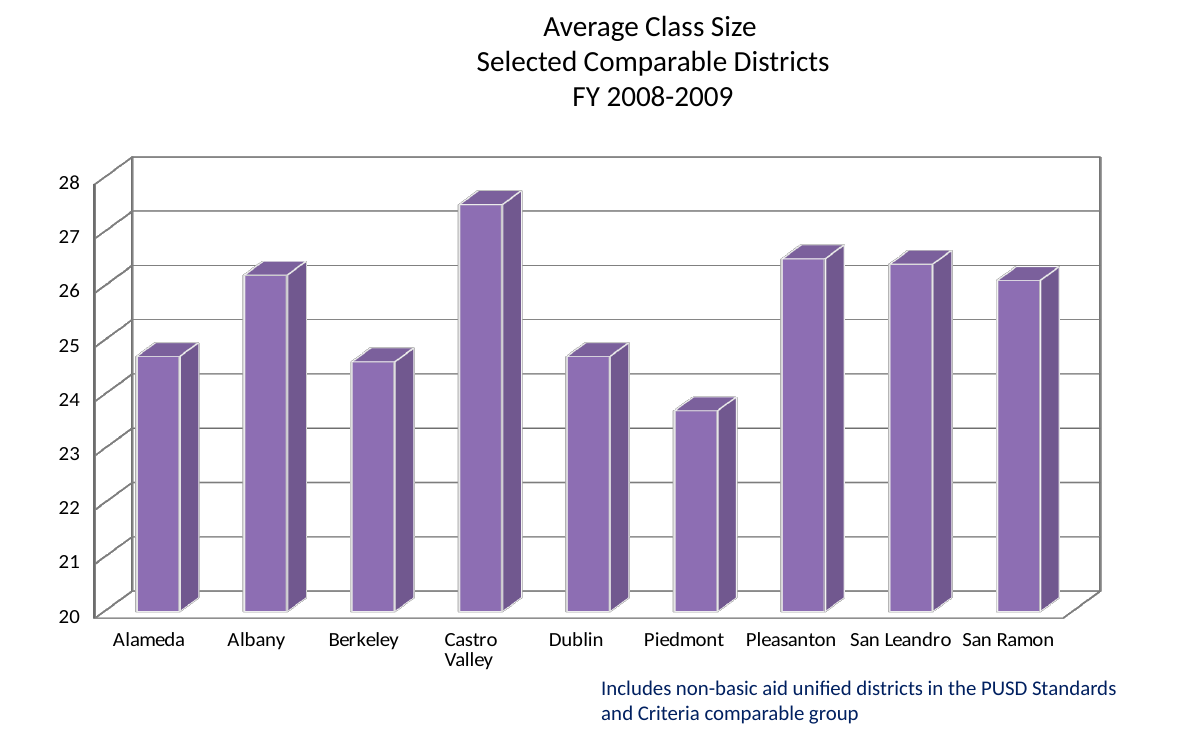
How many districts are shown on the chart? 9 Is the value for Castro Valley greater or less than 27? greater Which district has the lowest average class size? Piedmont Is the value for Pleasanton greater or less than 26? greater Is the value for Albany greater or less than 26? greater Which has a larger average class size, Piedmont or Berkeley? Berkeley Which fiscal year does the chart title say the data covers? FY 2008-2009 What kind of chart is shown on the slide? bar chart Which has a larger average class size, Albany or Alameda? Albany Which district has the highest average class size? Castro Valley